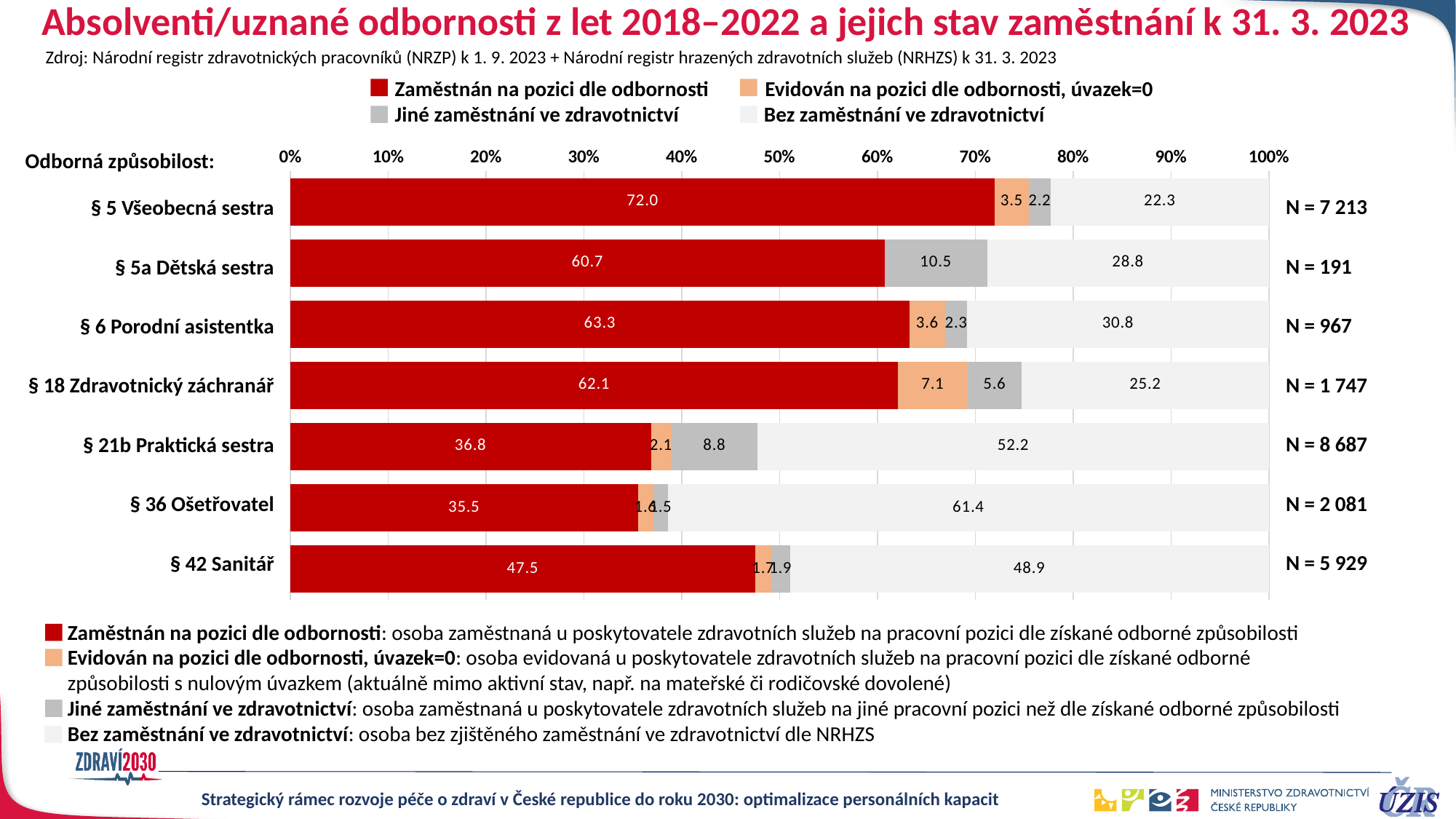
What is the value of 'Bez zaměstnání ve zdravotnictví' for § 21b Praktická sestra? 52.2 What is the N value shown for § 21b Praktická sestra? N = 8 687 Which has a larger 'Jiné zaměstnání ve zdravotnictví' share: § 5a Dětská sestra or § 18 Zdravotnický záchranář? § 5a Dětská sestra What is the difference between the 'Bez zaměstnání ve zdravotnictví' values for § 36 Ošetřovatel and § 5 Všeobecná sestra? 39.1 Which category has the highest share of 'Bez zaměstnání ve zdravotnictví'? § 36 Ošetřovatel How many series does the chart legend list? 4 Which category has the lowest share of 'Zaměstnán na pozici dle odbornosti'? § 36 Ošetřovatel What kind of chart is shown on the slide? stacked bar chart What colour represents 'Zaměstnán na pozici dle odbornosti' in the chart? red What is the value of 'Zaměstnán na pozici dle odbornosti' for § 5 Všeobecná sestra? 72.0 How many categories (odborné způsobilosti) are plotted in the chart? 7 Which category has the highest share of 'Zaměstnán na pozici dle odbornosti'? § 5 Všeobecná sestra